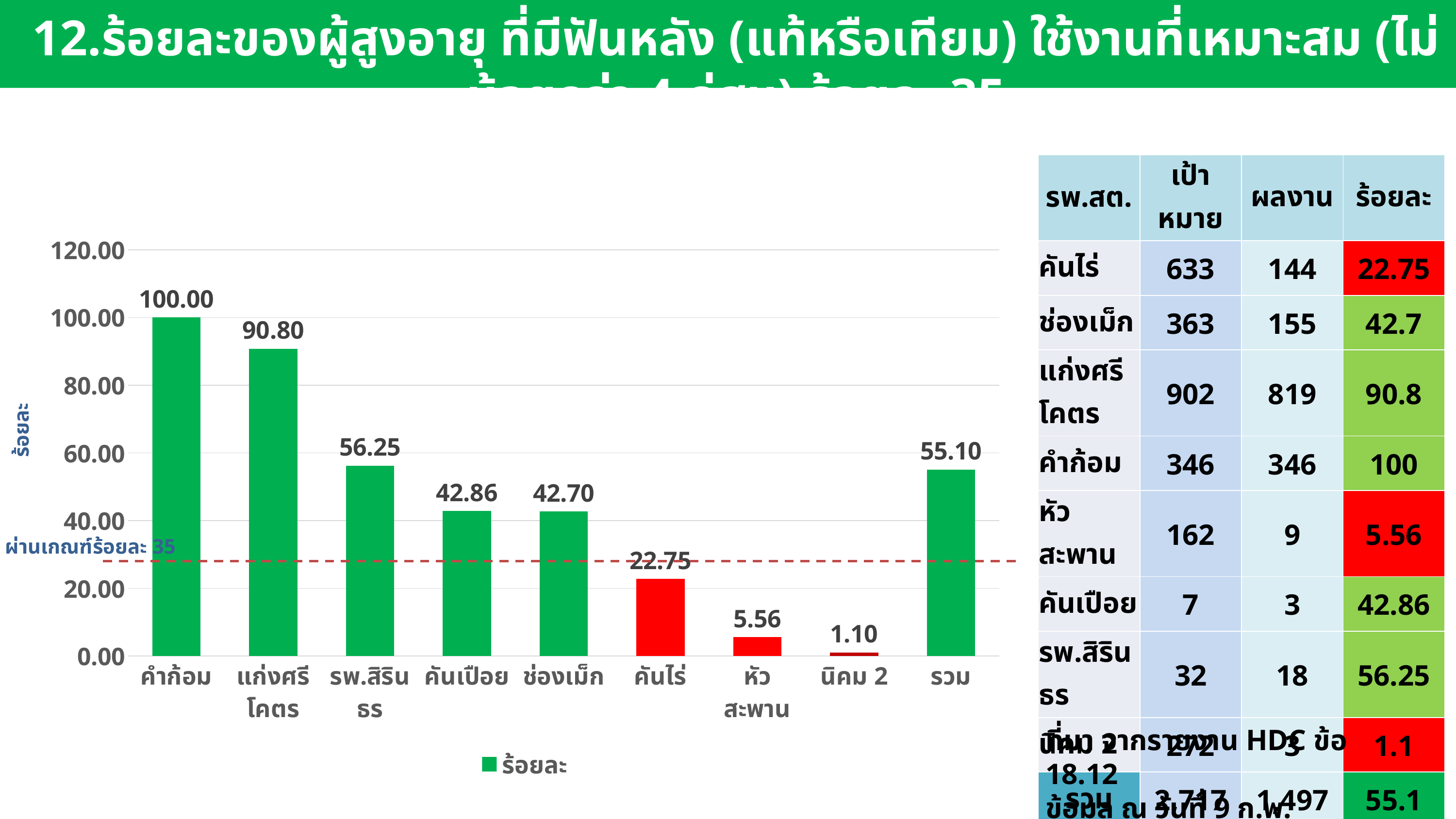
Is the value for คันไร่ greater or less than 40.00? less What is the value for คำก้อม in the bar chart? 100.00 What is the value for รวม in the bar chart? 55.10 What kind of chart is shown on the slide? bar chart Which is larger, the value for รพ.สิรินธร or the value for รวม? รพ.สิรินธร Which category has the lowest value in the bar chart? นิคม 2 What is the difference between the values for คำก้อม and แก่งศรีโคตร? 9.20 What is the value for แก่งศรีโคตร in the bar chart? 90.80 What is the legend entry of the chart? ร้อยละ What is the value for หัวสะพาน in the bar chart? 5.56 How many categories are shown on the x axis of the bar chart? 9 Which category has the highest value in the bar chart? คำก้อม